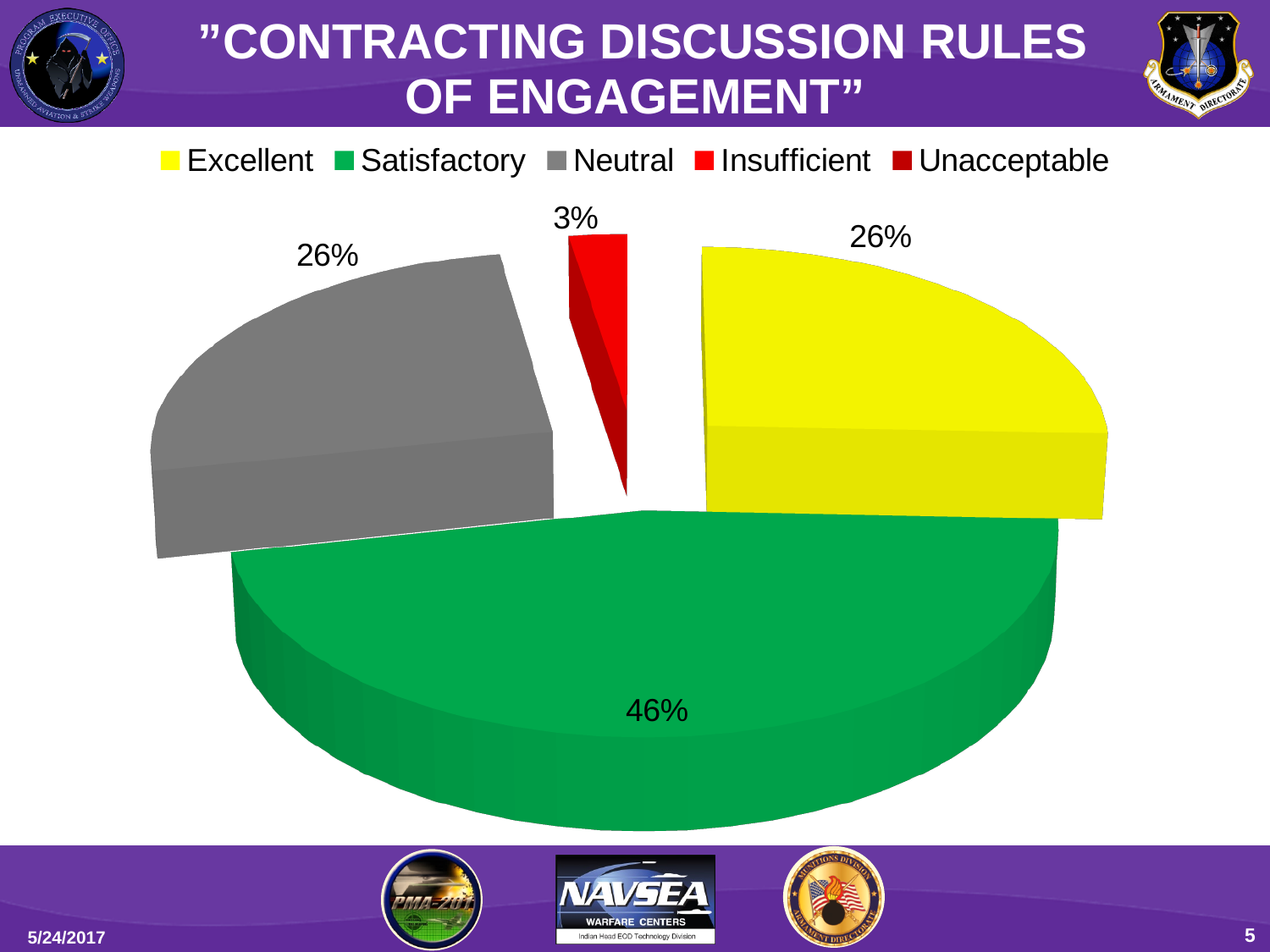
What percentage is shown for the Excellent slice? 26% By how many percentage points does the Satisfactory slice exceed the Insufficient slice? 43 percentage points What percentage of the pie is labelled for the Satisfactory slice? 46% How many entries does the legend list? 5 Which category has the largest slice of the pie? Satisfactory What colour represents the Satisfactory category in the chart? Green What kind of chart is shown on the slide? Pie chart What is the title of the slide containing the pie chart? "Contracting Discussion Rules of Engagement" What percentage is shown for the Insufficient slice? 3% Which slice is larger, Satisfactory or Neutral? Satisfactory What percentage is shown for the Neutral slice? 26% Which labelled slice of the pie is the smallest? Insufficient